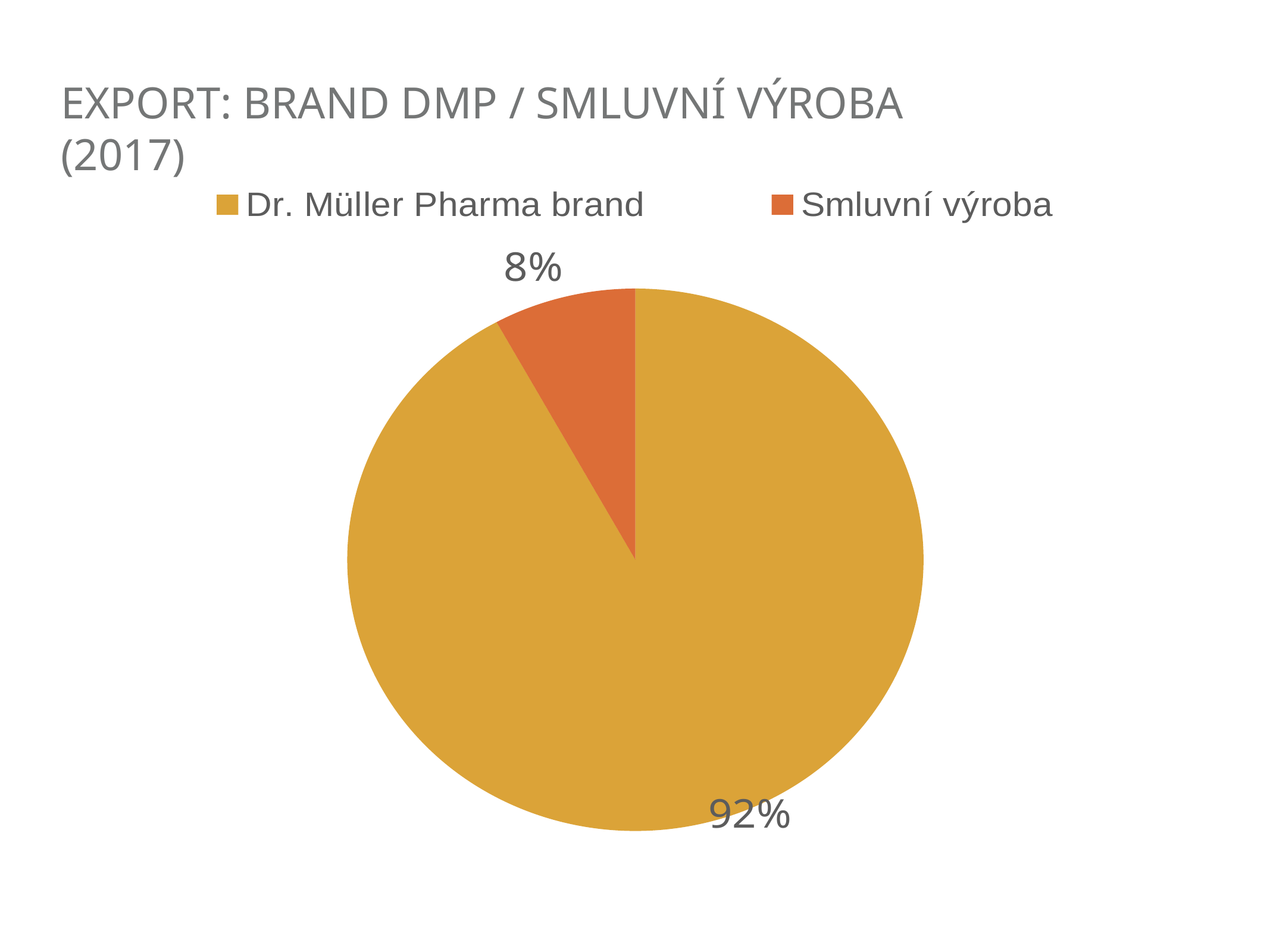
How many slices does the pie chart have? 2 What share of the pie does Dr. Müller Pharma brand hold? 92% Which category has the largest slice of the pie? Dr. Müller Pharma brand How many entries does the legend list? 2 What is the title of the slide? EXPORT: BRAND DMP / SMLUVNÍ VÝROBA (2017) What kind of chart is shown on the slide? Pie chart Which is larger, the Dr. Müller Pharma brand slice or the Smluvní výroba slice? Dr. Müller Pharma brand What share of the pie does Smluvní výroba hold? 8% What colour is the Smluvní výroba slice? Orange Which category has the smallest slice of the pie? Smluvní výroba What is the difference in percentage points between the Dr. Müller Pharma brand slice and the Smluvní výroba slice? 84 percentage points